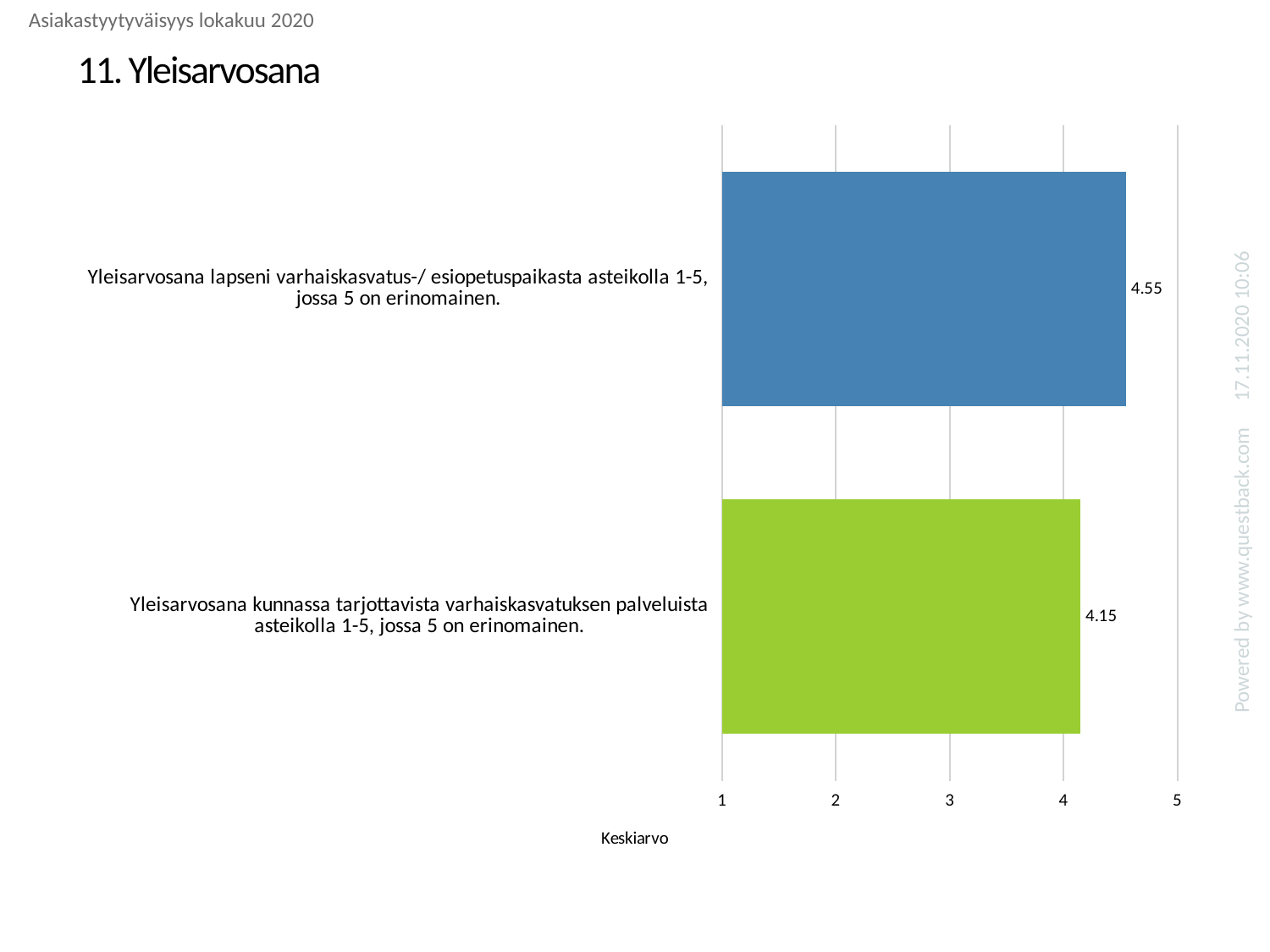
Which is larger: the value for 'Yleisarvosana lapseni varhaiskasvatus-/ esiopetuspaikasta' or the value for 'Yleisarvosana kunnassa tarjottavista varhaiskasvatuksen palveluista'? Yleisarvosana lapseni varhaiskasvatus-/ esiopetuspaikasta What is the difference between the value for the child's daycare/preschool place (4.55) and the value for the municipality's early childhood education services (4.15)? 0.4 What is the title of the chart? 11. Yleisarvosana Which category has the lowest value? Yleisarvosana kunnassa tarjottavista varhaiskasvatuksen palveluista asteikolla 1-5, jossa 5 on erinomainen. Is the value for 'Yleisarvosana lapseni varhaiskasvatus-/ esiopetuspaikasta' greater or less than 5? less How many categories are shown in the chart? 2 What is the label of the horizontal axis? Keskiarvo What is the value for 'Yleisarvosana lapseni varhaiskasvatus-/ esiopetuspaikasta asteikolla 1-5, jossa 5 on erinomainen.'? 4.55 What is the value for 'Yleisarvosana kunnassa tarjottavista varhaiskasvatuksen palveluista asteikolla 1-5, jossa 5 on erinomainen.'? 4.15 Which category has the highest value? Yleisarvosana lapseni varhaiskasvatus-/ esiopetuspaikasta asteikolla 1-5, jossa 5 on erinomainen. Is the value for 'Yleisarvosana kunnassa tarjottavista varhaiskasvatuksen palveluista' greater or less than 4? greater What kind of chart is shown on the slide? bar chart